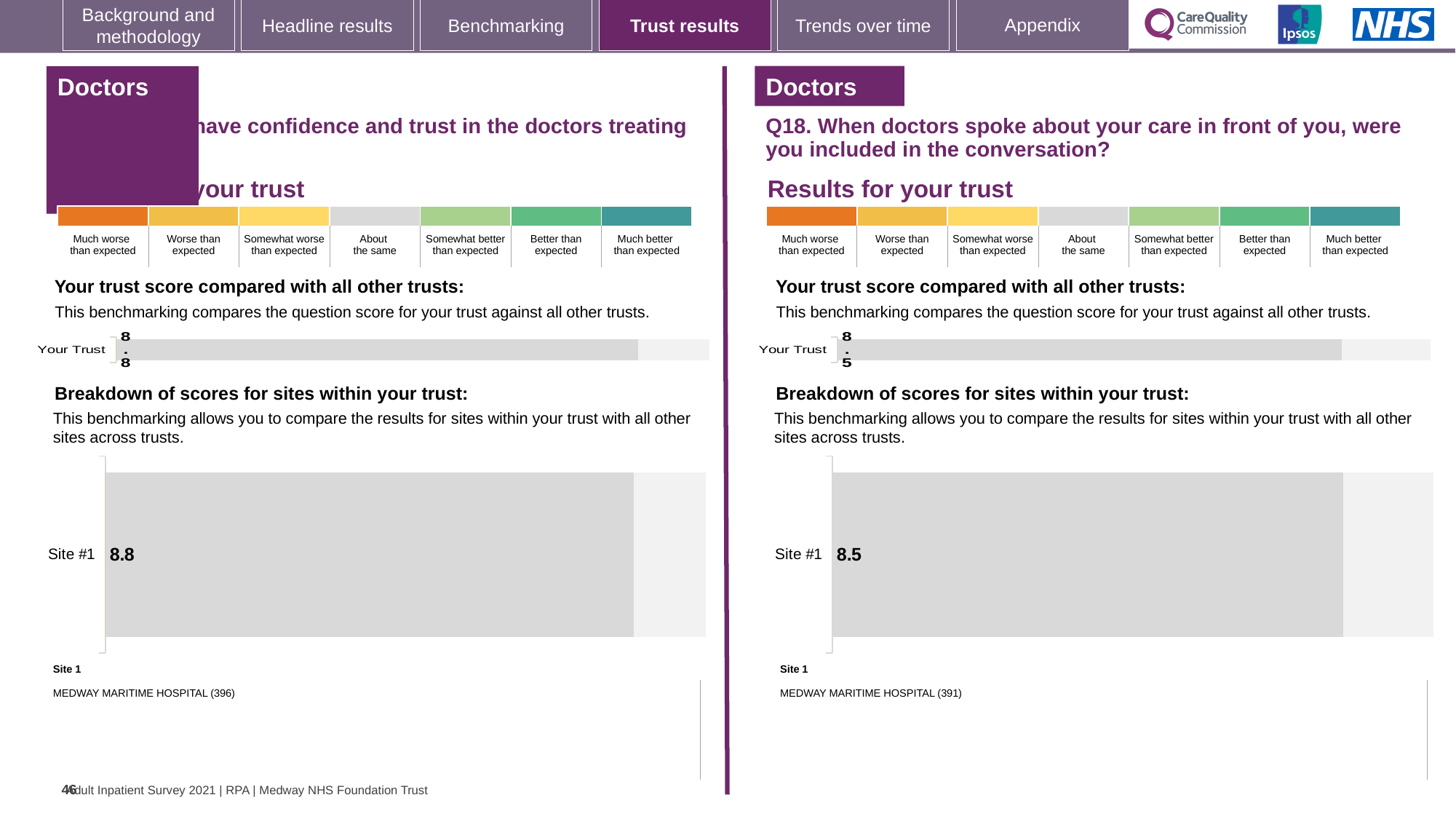
What type of chart is used for the 'Your trust score compared with all other trusts' section on the right-hand side? Bar chart On the right-hand Q18 'Breakdown of scores for sites within your trust' chart, what is the score for Site #1? 8.5 On the left-hand 'Breakdown of scores for sites within your trust' chart, what is the score for Site #1? 8.8 On the right-hand Q18 breakdown chart, which hospital is listed as Site 1? MEDWAY MARITIME HOSPITAL (391) What is the difference between the Site #1 score on the left-hand breakdown chart and the Site #1 score on the right-hand Q18 breakdown chart? 0.3 On the left-hand breakdown chart, which hospital is listed as Site 1? MEDWAY MARITIME HOSPITAL (396) On the left-hand 'Your trust score compared with all other trusts' chart, what is the value shown for Your Trust? 8.8 How many sites are plotted on the left-hand 'Breakdown of scores for sites within your trust' chart? 1 What type of chart is used for the 'Breakdown of scores for sites within your trust' section on the left-hand side? Bar chart How many sites are plotted on the right-hand Q18 'Breakdown of scores for sites within your trust' chart? 1 On the right-hand Q18 'Your trust score compared with all other trusts' chart, what is the value shown for Your Trust? 8.5 Which is larger: the Your Trust score on the left-hand chart or the Your Trust score on the right-hand Q18 chart? The left-hand chart (8.8)